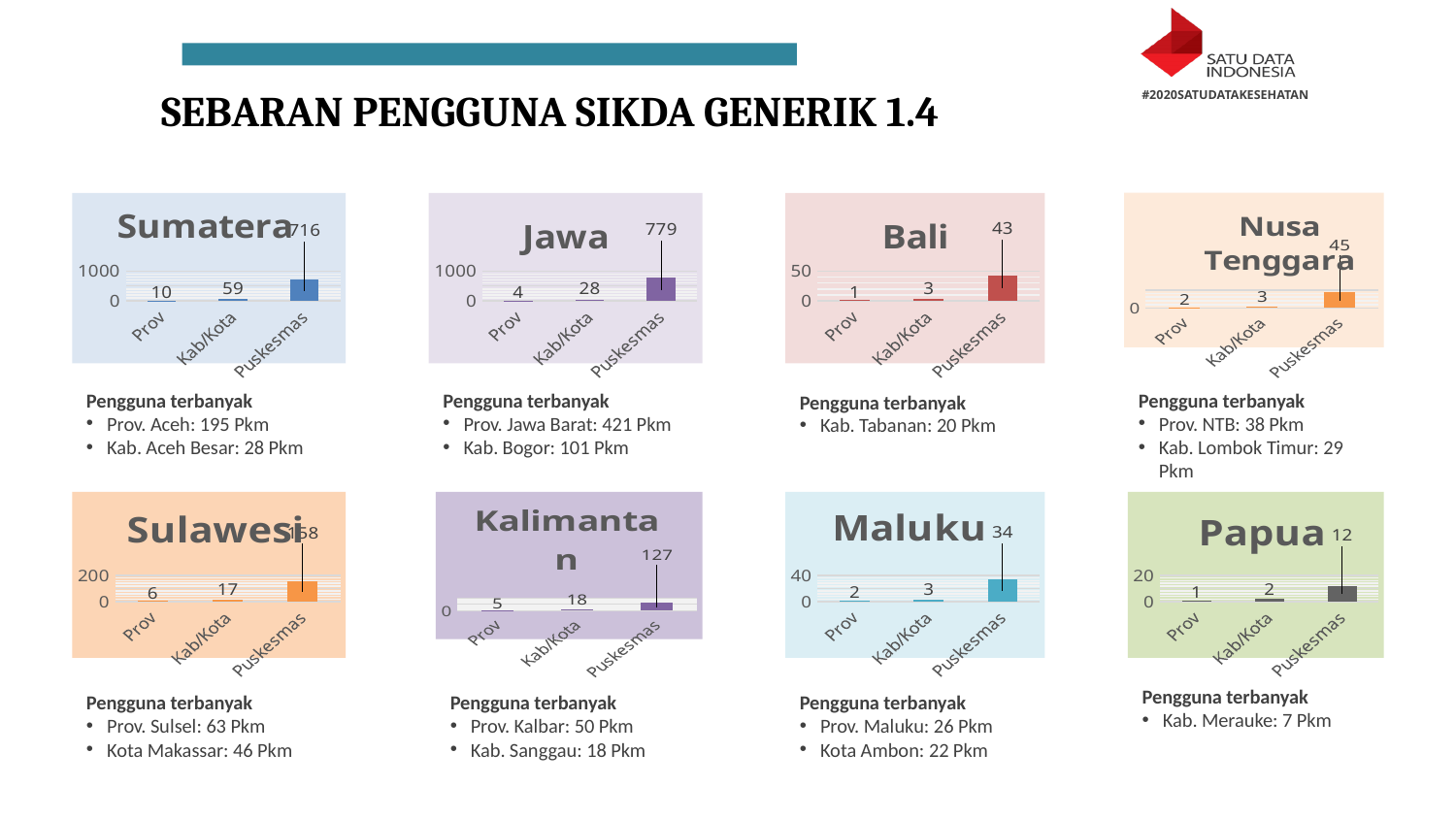
Which is larger: the Puskesmas value in the Sumatera chart or the Puskesmas value in the Jawa chart? Jawa In the Sumatera chart, what is the value for Puskesmas? 716 In the Maluku chart, do the values rise or fall from Prov to Puskesmas? Rise In the Jawa chart, what is the value for Kab/Kota? 28 In the Kalimantan chart, what is the value for Prov? 5 In the Jawa chart, what is the difference between the Puskesmas value and the Kab/Kota value? 751 In the Papua chart, which category has the highest value? Puskesmas How many categories are shown on the x axis of the Nusa Tenggara chart? 3 In the Maluku chart, which category has the lowest value? Prov In the Bali chart, what is the value for Puskesmas? 43 What kind of chart is the Kalimantan chart? Bar chart How many regional charts are shown on the slide? 8